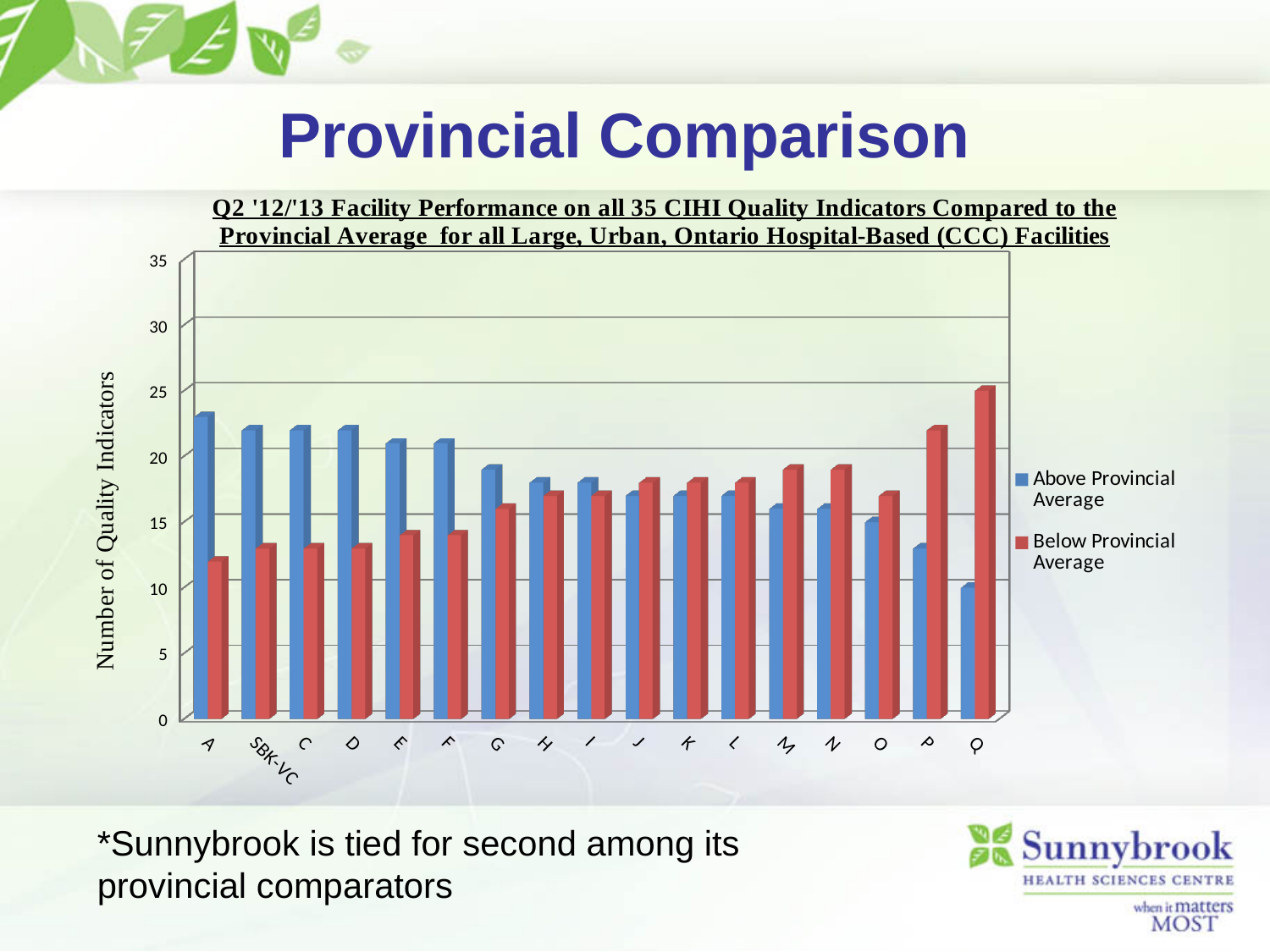
What kind of chart is shown on the slide? Bar chart How many series does the legend list? 2 For facility SBK-VC, which is larger: the Above Provincial Average value or the Below Provincial Average value? Above Provincial Average Which facility has the highest Below Provincial Average value? Q How many facilities (categories) are shown on the x axis? 17 What is the title of the vertical axis? Number of Quality Indicators Do the Above Provincial Average values generally rise or fall moving from A to Q along the x axis? Fall Is the Above Provincial Average value for facility A greater or less than 20? greater Is the Below Provincial Average value for facility A greater or less than 15? less Is the Above Provincial Average value for facility O greater or less than 20? less Which facility has the lowest Above Provincial Average value? Q